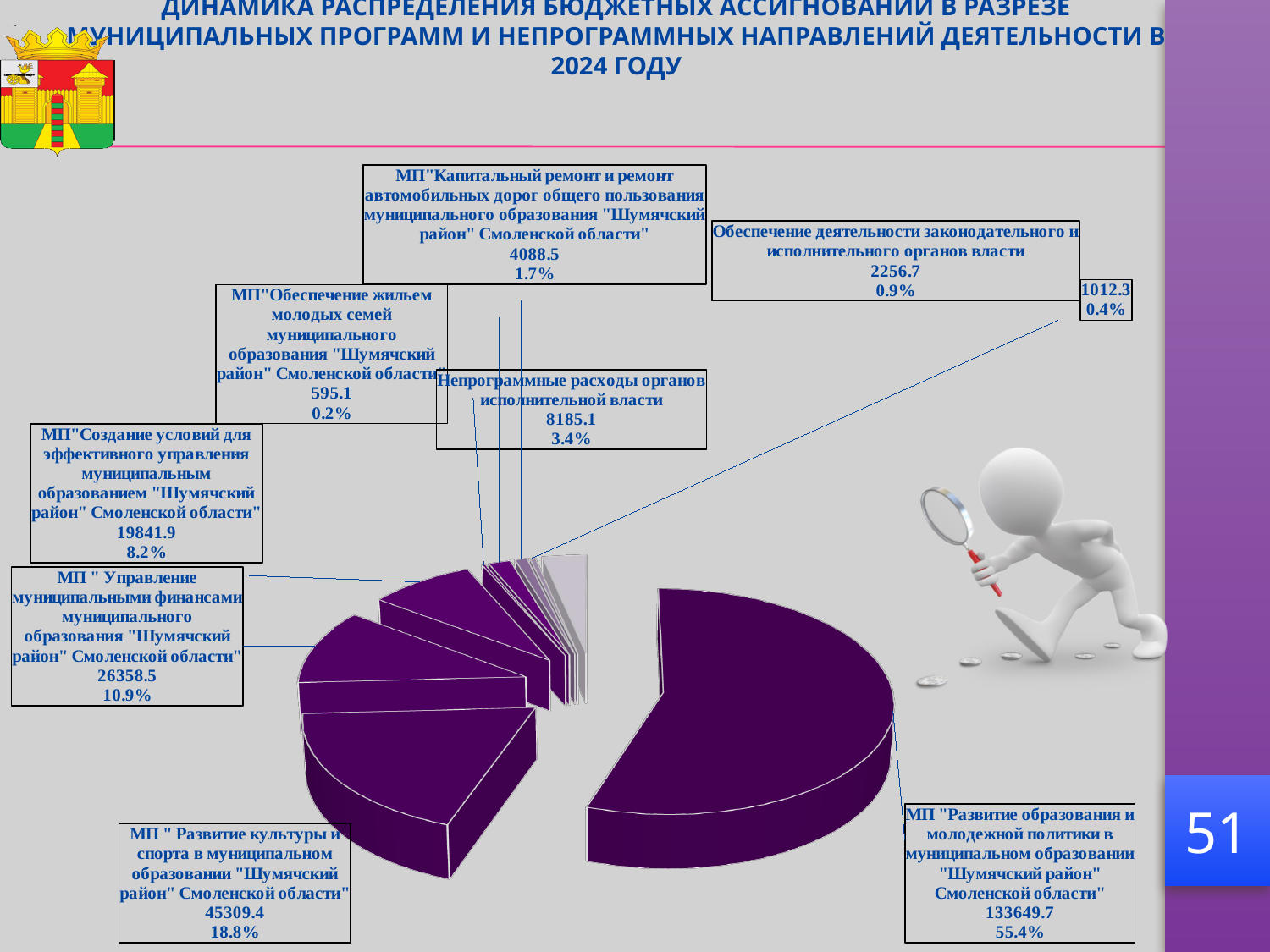
What value is shown for МП "Развитие культуры и спорта"? 45309.4 What value is shown for МП "Развитие образования и молодежной политики"? 133649.7 What is the difference between the values for МП "Развитие культуры и спорта" (45309.4) and МП "Управление муниципальными финансами" (26358.5)? 18950.9 What share of the pie does МП "Развитие образования и молодежной политики" represent? 55.4% Which category has the largest share of the pie? МП "Развитие образования и молодежной политики" What kind of chart is shown on the slide? pie chart Which named category has the smallest value? МП "Обеспечение жильем молодых семей" What value is shown for Обеспечение деятельности законодательного и исполнительного органов власти? 2256.7 Which is larger: the value for МП "Создание условий для эффективного управления" or for Непрограммные расходы органов исполнительной власти? МП "Создание условий для эффективного управления" What percentage is shown for МП "Обеспечение жильем молодых семей"? 0.2% What percentage is shown for МП "Управление муниципальными финансами"? 10.9% What value is shown for Непрограммные расходы органов исполнительной власти? 8185.1